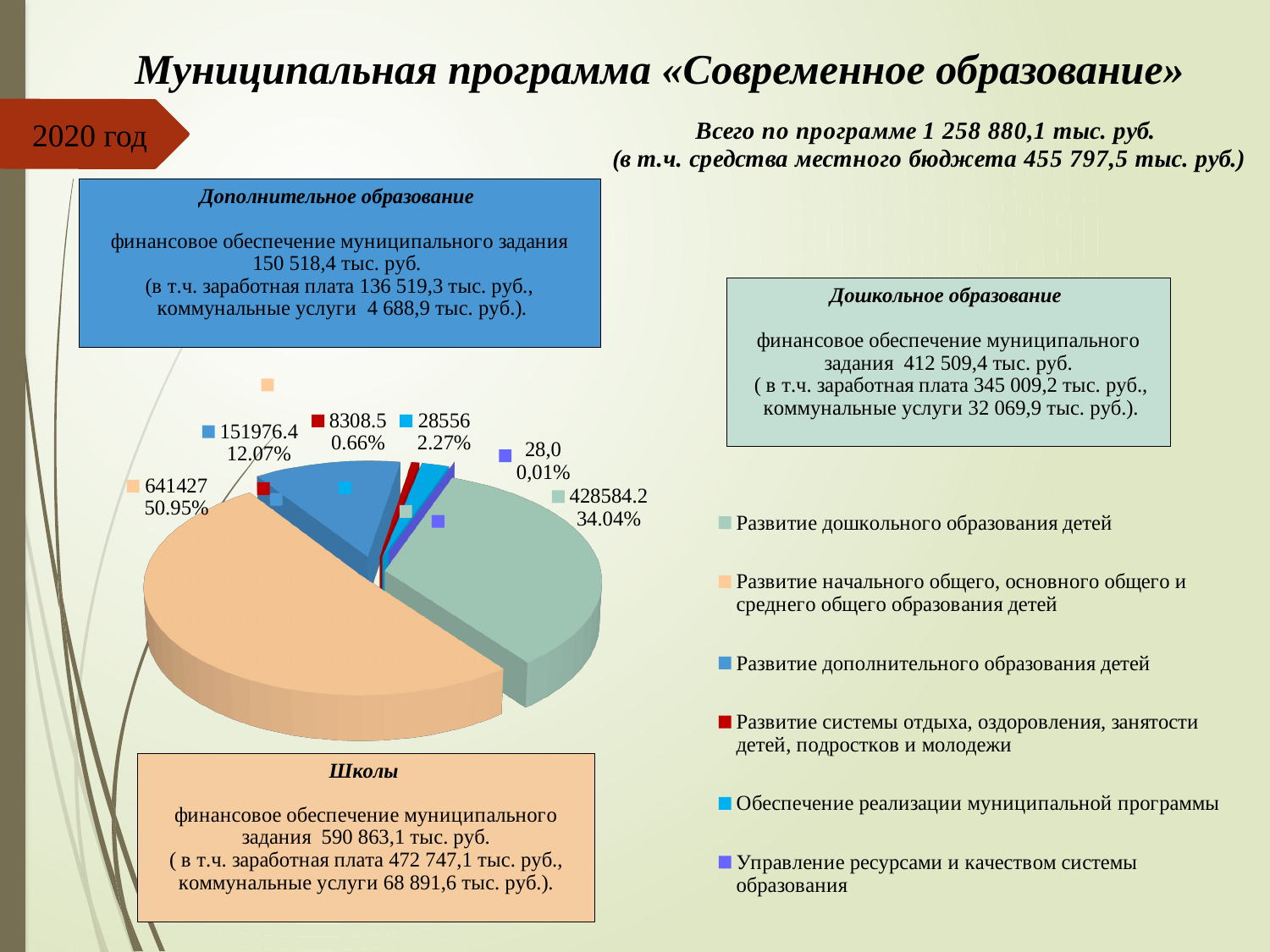
What percentage is shown for the slice 'Управление ресурсами и качеством системы образования'? 0,01% How many entries does the legend of the pie chart list? 6 What is the value shown for the slice 'Развитие дополнительного образования детей'? 151976.4 Which is larger: the slice for 'Развитие дошкольного образования детей' or the slice for 'Развитие дополнительного образования детей'? Развитие дошкольного образования детей What is the value shown for the slice 'Развитие начального общего, основного общего и среднего общего образования детей'? 641427 Which slice of the pie chart is the largest? Развитие начального общего, основного общего и среднего общего образования детей What type of chart is shown on the slide? pie chart What is the difference between the values 641427 and 428584.2 shown on the pie chart? 212842.8 What percentage is shown for the slice 'Развитие системы отдыха, оздоровления, занятости детей, подростков и молодежи'? 0.66% What share of the pie does the slice 'Развитие дошкольного образования детей' represent? 34.04% Which slice of the pie chart is the smallest? Управление ресурсами и качеством системы образования What is the value shown for the slice 'Обеспечение реализации муниципальной программы'? 28556